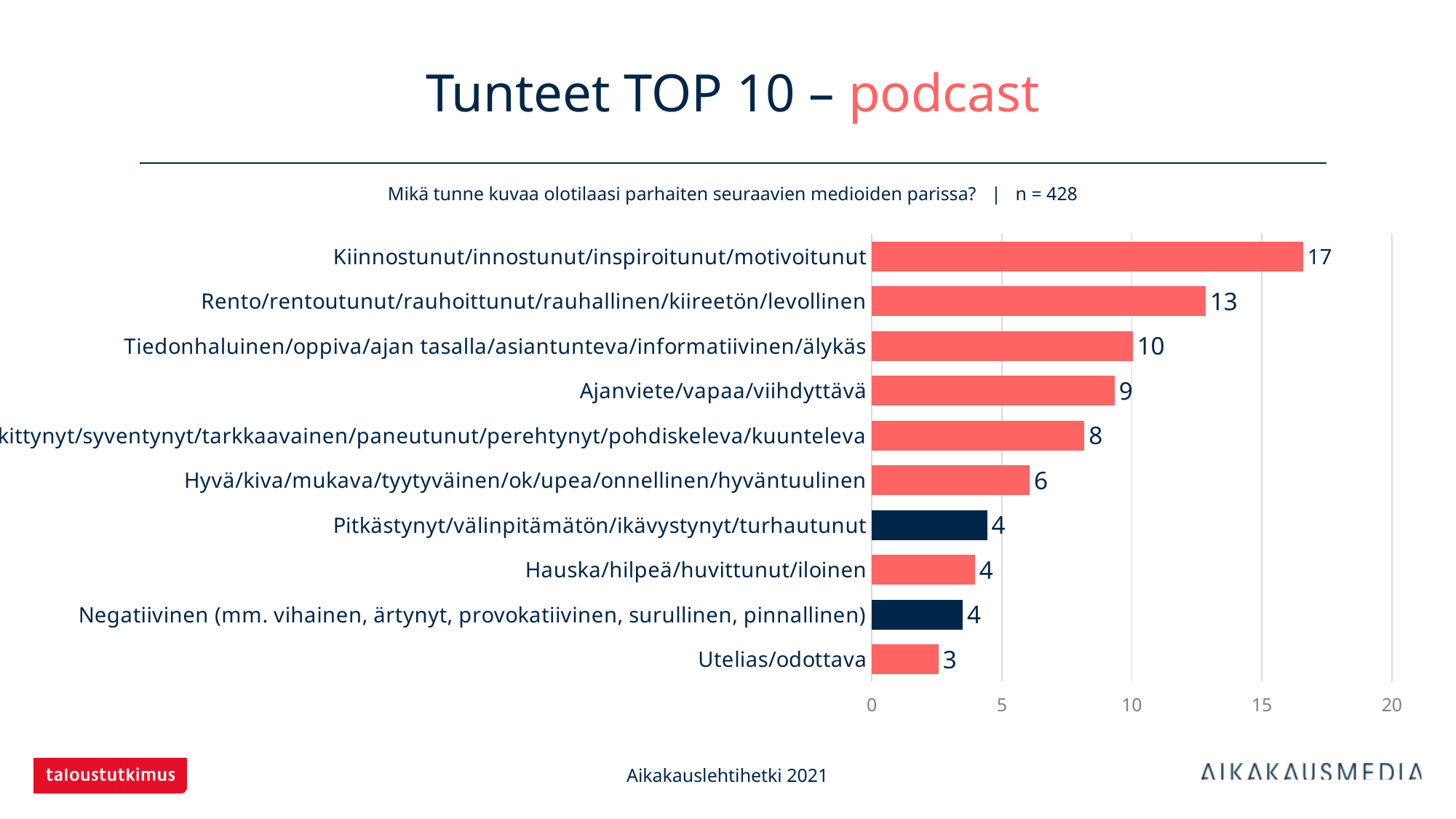
What is the value for Utelias/odottava? 3 What kind of chart is shown on the slide? bar chart What is the value for Kiinnostunut/innostunut/inspiroitunut/motivoitunut? 17 How many categories are shown in the chart? 10 What is the value for Ajanviete/vapaa/viihdyttävä? 9 What is the difference between the values for Kiinnostunut/innostunut/inspiroitunut/motivoitunut and Rento/rentoutunut/rauhoittunut/rauhallinen/kiireetön/levollinen? 4 Which category has the lowest value? Utelias/odottava What is the value for Rento/rentoutunut/rauhoittunut/rauhallinen/kiireetön/levollinen? 13 Which category has the highest value? Kiinnostunut/innostunut/inspiroitunut/motivoitunut What is the title of the slide? Tunteet TOP 10 – podcast Which is larger, the value for Tiedonhaluinen/oppiva/ajan tasalla/asiantunteva/informatiivinen/älykäs or the value for Hyvä/kiva/mukava/tyytyväinen/ok/upea/onnellinen/hyväntuulinen? Tiedonhaluinen/oppiva/ajan tasalla/asiantunteva/informatiivinen/älykäs What is the sample size (n) stated on the slide? 428